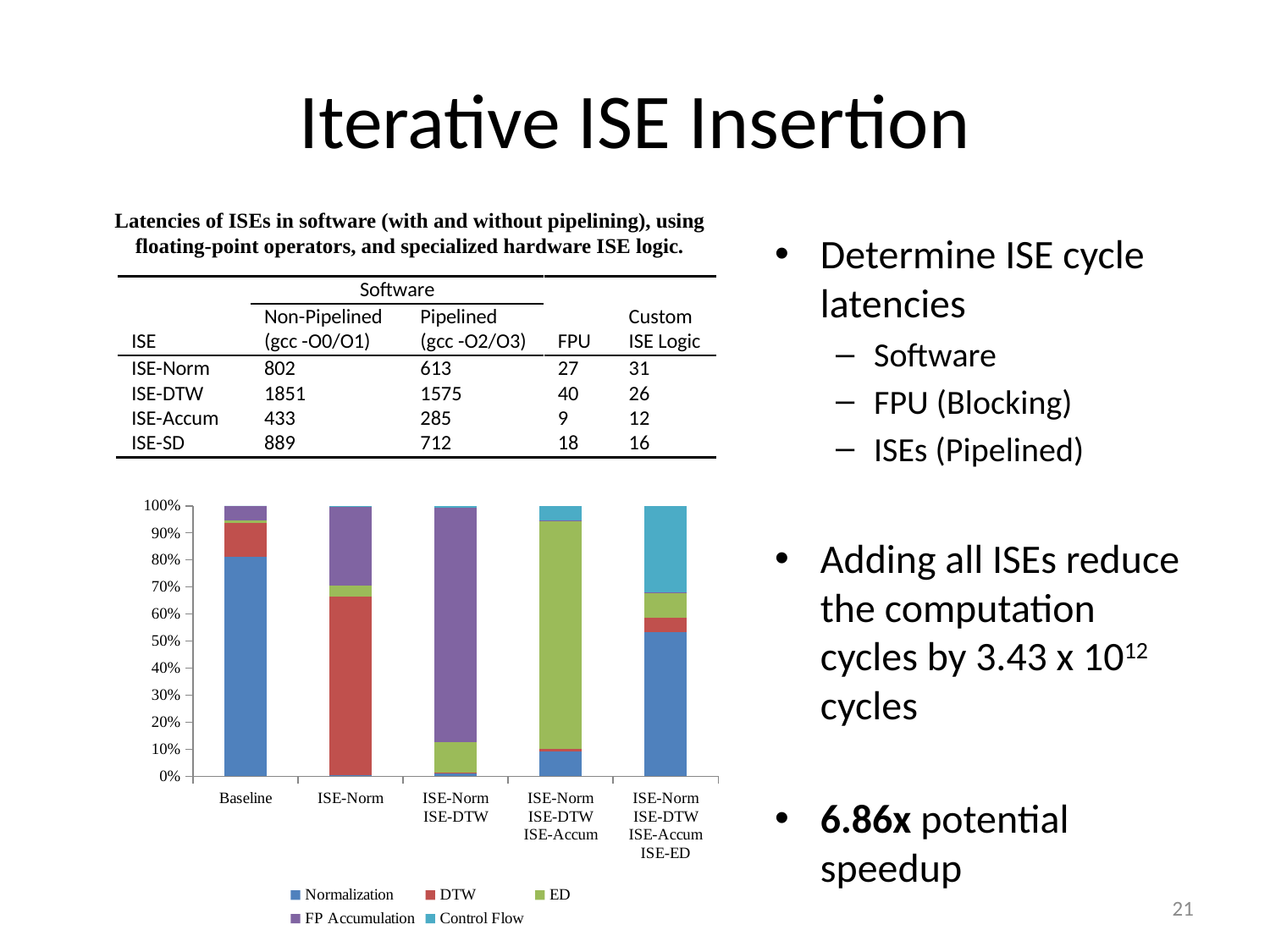
Is the Control Flow share of the ISE-Norm ISE-DTW ISE-Accum ISE-ED bar greater or less than 20%? greater Is the DTW share of the ISE-Norm bar greater or less than 50%? greater What kind of chart is shown on the slide? Stacked bar chart Is the ED share of the ISE-Norm ISE-DTW ISE-Accum bar greater or less than 80%? greater In the Baseline bar, which is larger: the Normalization share or the DTW share? Normalization How many series does the chart's legend list? 5 Which series is shown in green in the chart? ED Which category has the largest Control Flow share? ISE-Norm ISE-DTW ISE-Accum ISE-ED Which series is shown in blue in the chart? Normalization How many categories are shown along the x axis of the chart? 5